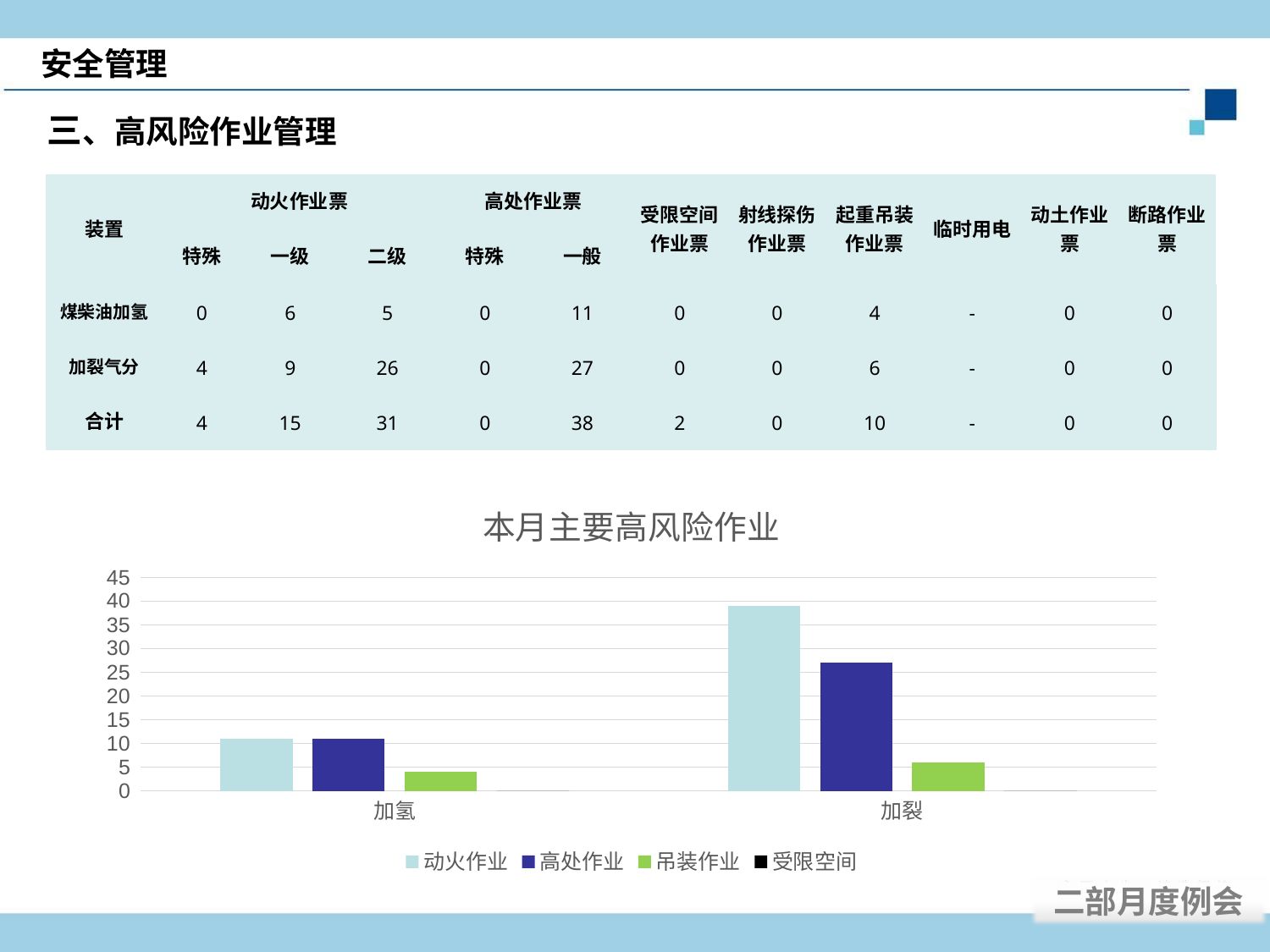
Which category has the taller 动火作业 bar, 加氢 or 加裂? 加裂 Is the value for 吊装作业 in 加氢 greater or less than 10? less Which series is shown in light blue in the chart legend? 动火作业 For 加裂, is the 动火作业 bar larger or smaller than the 高处作业 bar? larger What is the title of the chart? 本月主要高风险作业 For 加裂, which series has the tallest bar? 动火作业 Is the value for 动火作业 in 加裂 greater or less than 35? greater Is the value for 高处作业 in 加裂 greater or less than 20? greater How many categories are shown on the x axis of the chart? 2 How many series does the chart legend list? 4 What type of chart is shown on the slide? bar chart